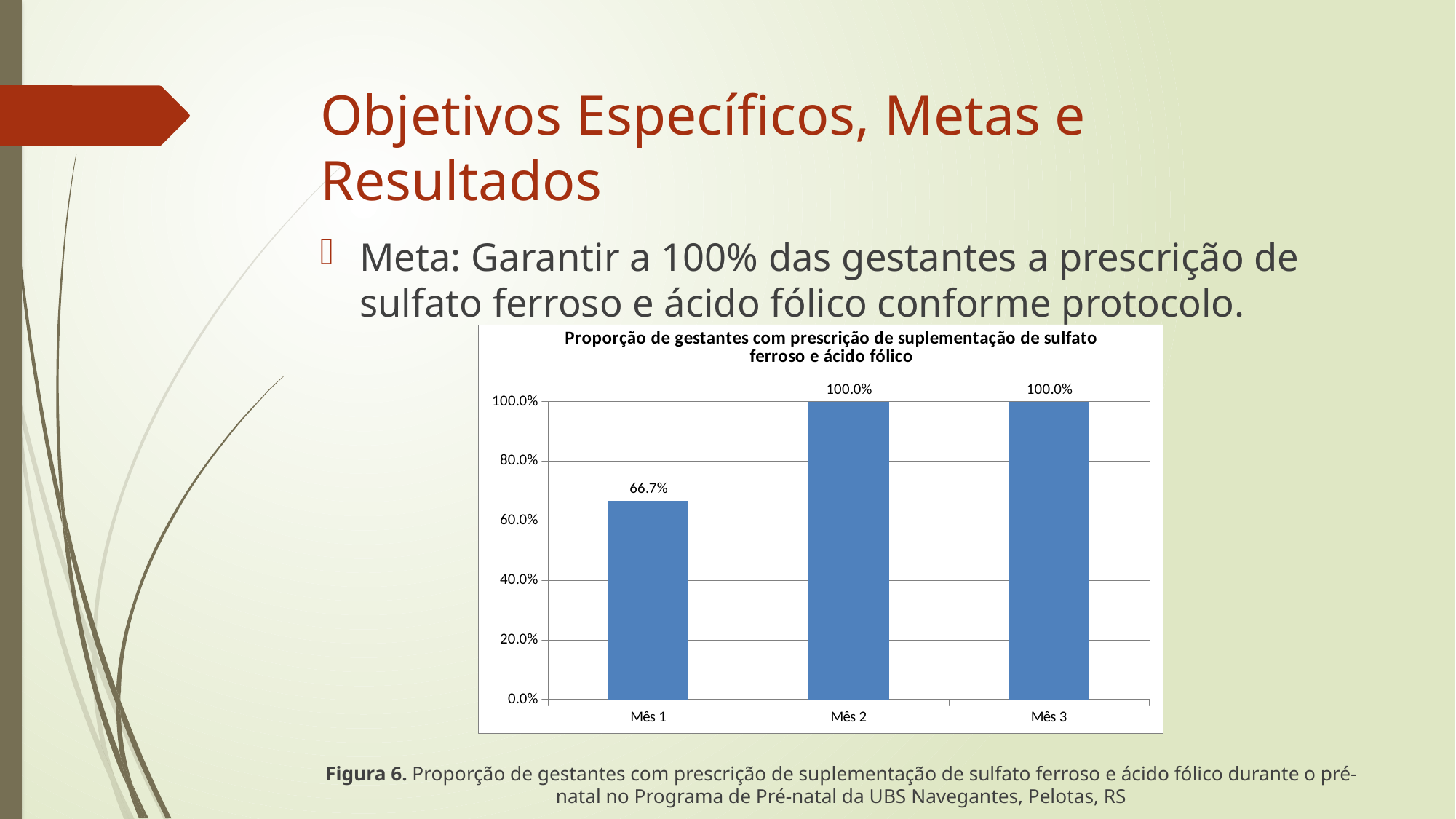
What is the title of the chart? Proporção de gestantes com prescrição de suplementação de sulfato ferroso e ácido fólico What is the highest tick value shown on the y axis? 100.0% What is the value for Mês 1? 66.7% Is the value for Mês 1 greater or less than 80.0%? less Which is larger, the value for Mês 1 or the value for Mês 3? Mês 3 What is the difference between the values for Mês 2 and Mês 1? 33.3% What is the value for Mês 2? 100.0% Which month has the lowest value? Mês 1 What kind of chart is shown on the slide? bar chart What is the value for Mês 3? 100.0% Do the values rise or fall from Mês 1 to Mês 2? rise How many months are shown on the x axis? 3